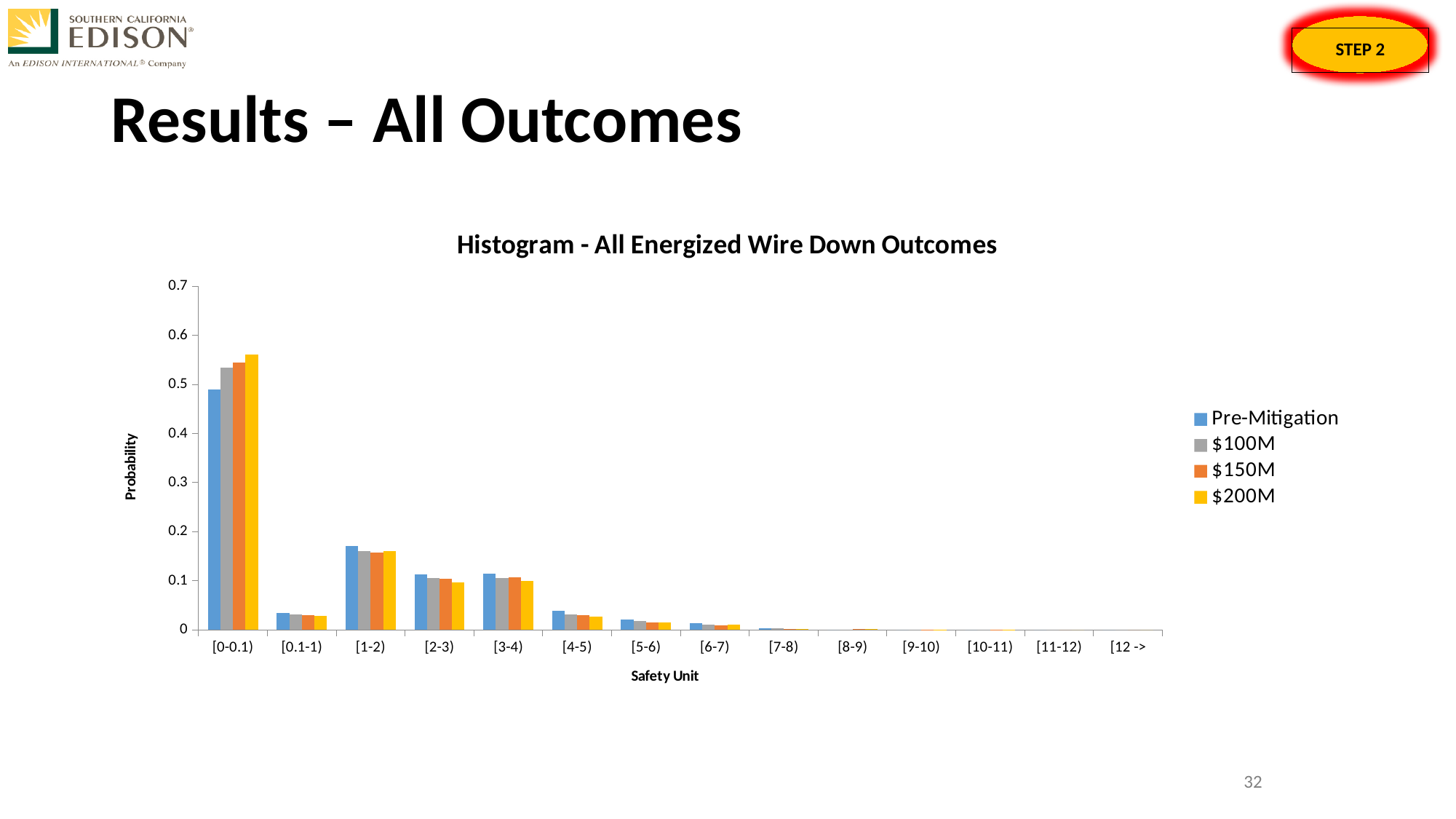
For the $200M series, which category has the highest value? [0-0.1) What kind of chart is shown on the slide? bar chart Which series has the highest value in the [1-2) category? Pre-Mitigation Is the $200M value for [0-0.1) greater or less than 0.5? greater Is the Pre-Mitigation value for [0-0.1) greater or less than 0.5? less Is the Pre-Mitigation value for [1-2) greater or less than 0.1? greater Which series has the highest value in the [0-0.1) category? $200M How many series does the legend list? 4 How many categories are shown on the x axis? 14 What is the title of the chart? Histogram - All Energized Wire Down Outcomes Do the Pre-Mitigation values rise or fall along the x axis from [1-2) to [12 ->? fall